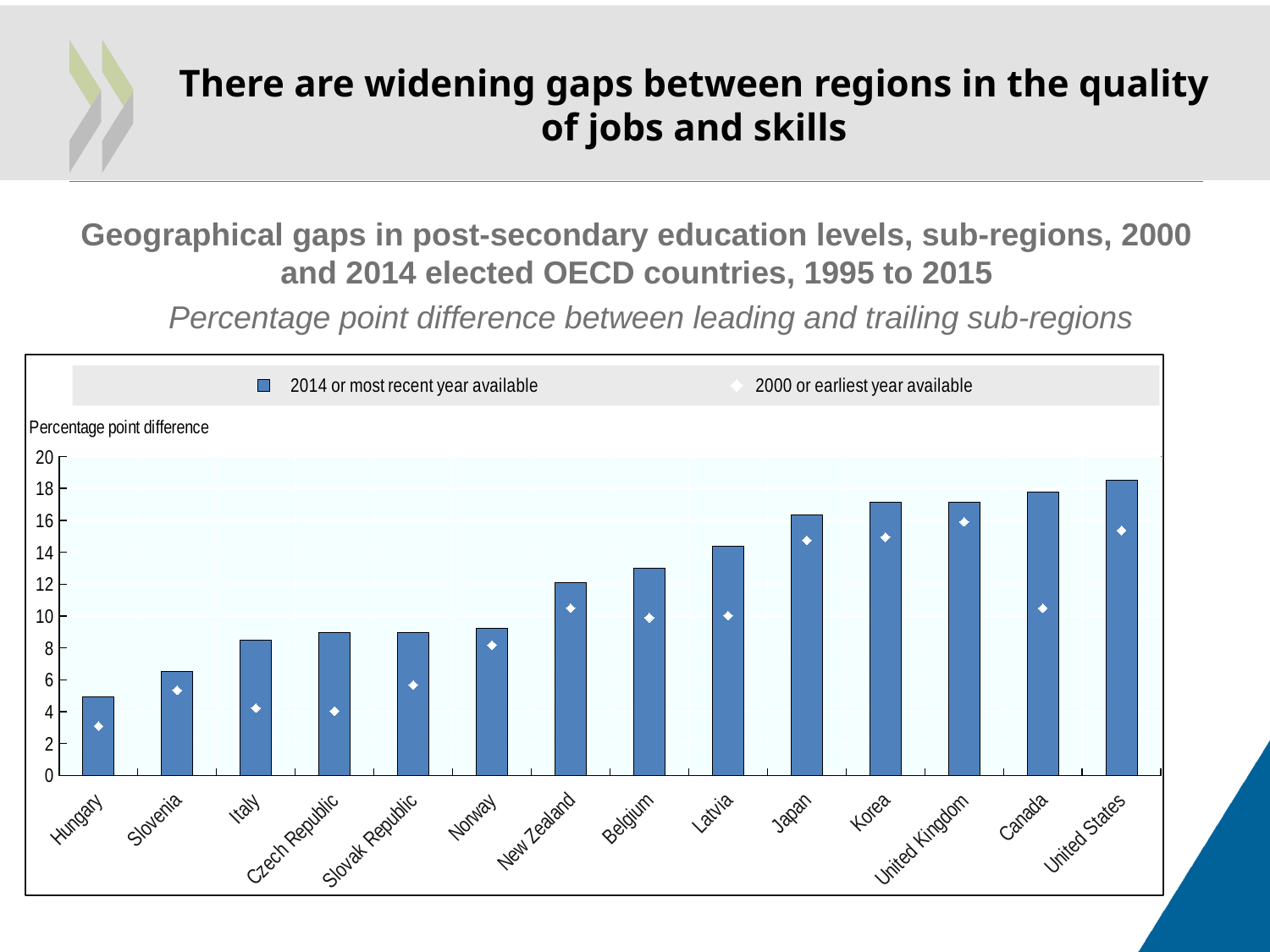
Is the 2000 or earliest year value for Hungary greater or less than 4? less What kind of chart is shown on the slide? bar chart What is the label on the y axis of the chart? Percentage point difference Is the 2014 or most recent year bar for Canada greater or less than 16? greater Is the 2014 or most recent year bar for Norway greater or less than 10? less Which country has the lowest bar for 2014 or most recent year available? Hungary Which has the larger 2014 or most recent year bar, Italy or Slovenia? Italy Do the bar values rise or fall moving from left to right along the x axis? rise How many countries are shown on the x axis of the chart? 14 How many series does the chart's legend list? 2 Which country has the highest bar for 2014 or most recent year available? United States